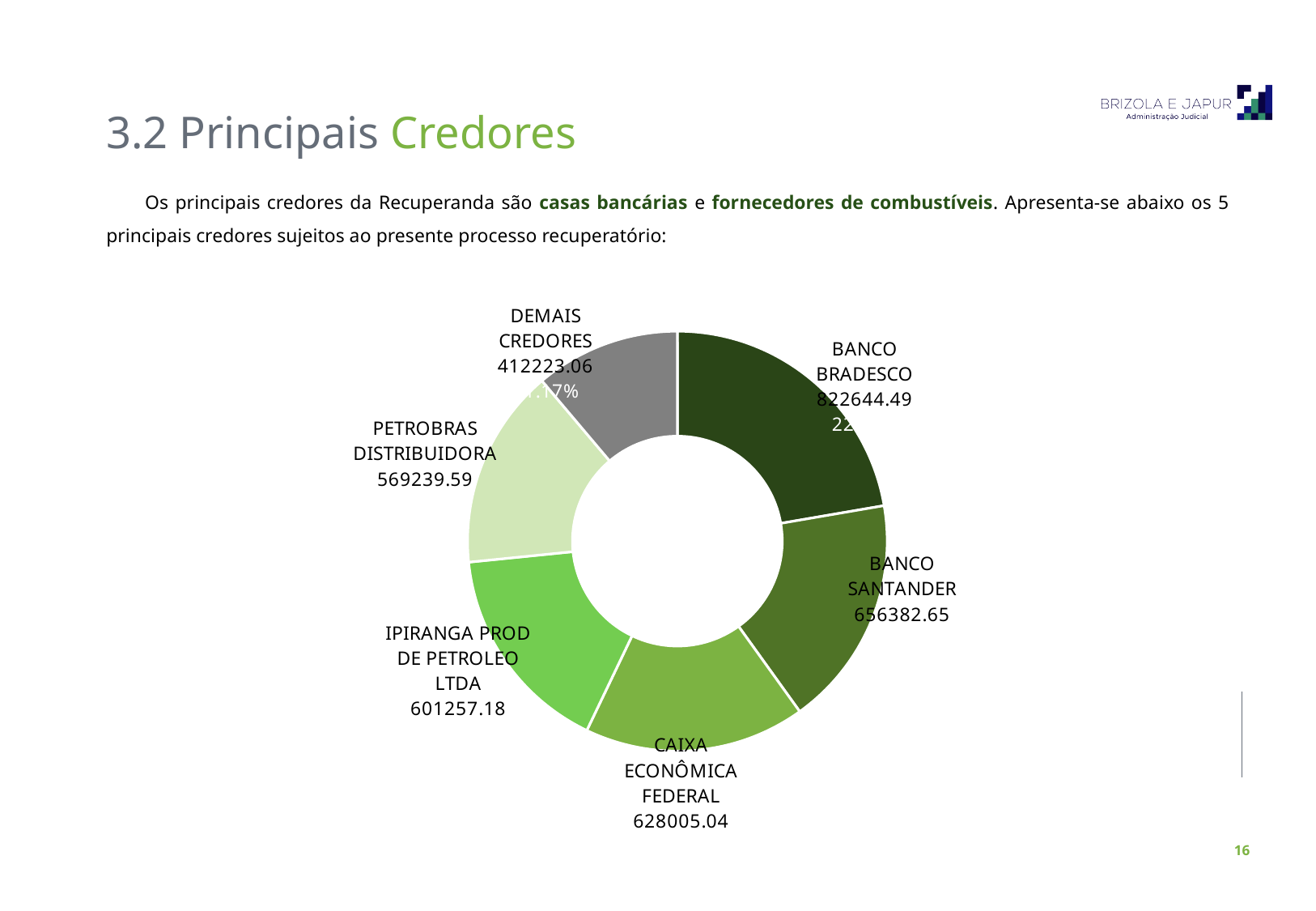
What is the difference between the values for BANCO BRADESCO and BANCO SANTANDER? 166261.84 Which category has the smallest value in the chart? DEMAIS CREDORES What kind of chart is shown on the slide? doughnut chart What is the value shown for PETROBRAS DISTRIBUIDORA? 569239.59 Which is larger, the value for IPIRANGA PROD DE PETROLEO LTDA or the value for PETROBRAS DISTRIBUIDORA? IPIRANGA PROD DE PETROLEO LTDA What is the value shown for BANCO SANTANDER? 656382.65 What is the value shown for CAIXA ECONÔMICA FEDERAL? 628005.04 How many categories (slices) does the chart show? 6 What is the value shown for DEMAIS CREDORES? 412223.06 What is the value shown for BANCO BRADESCO? 822644.49 What is the value shown for IPIRANGA PROD DE PETROLEO LTDA? 601257.18 Which creditor has the largest value in the chart? BANCO BRADESCO